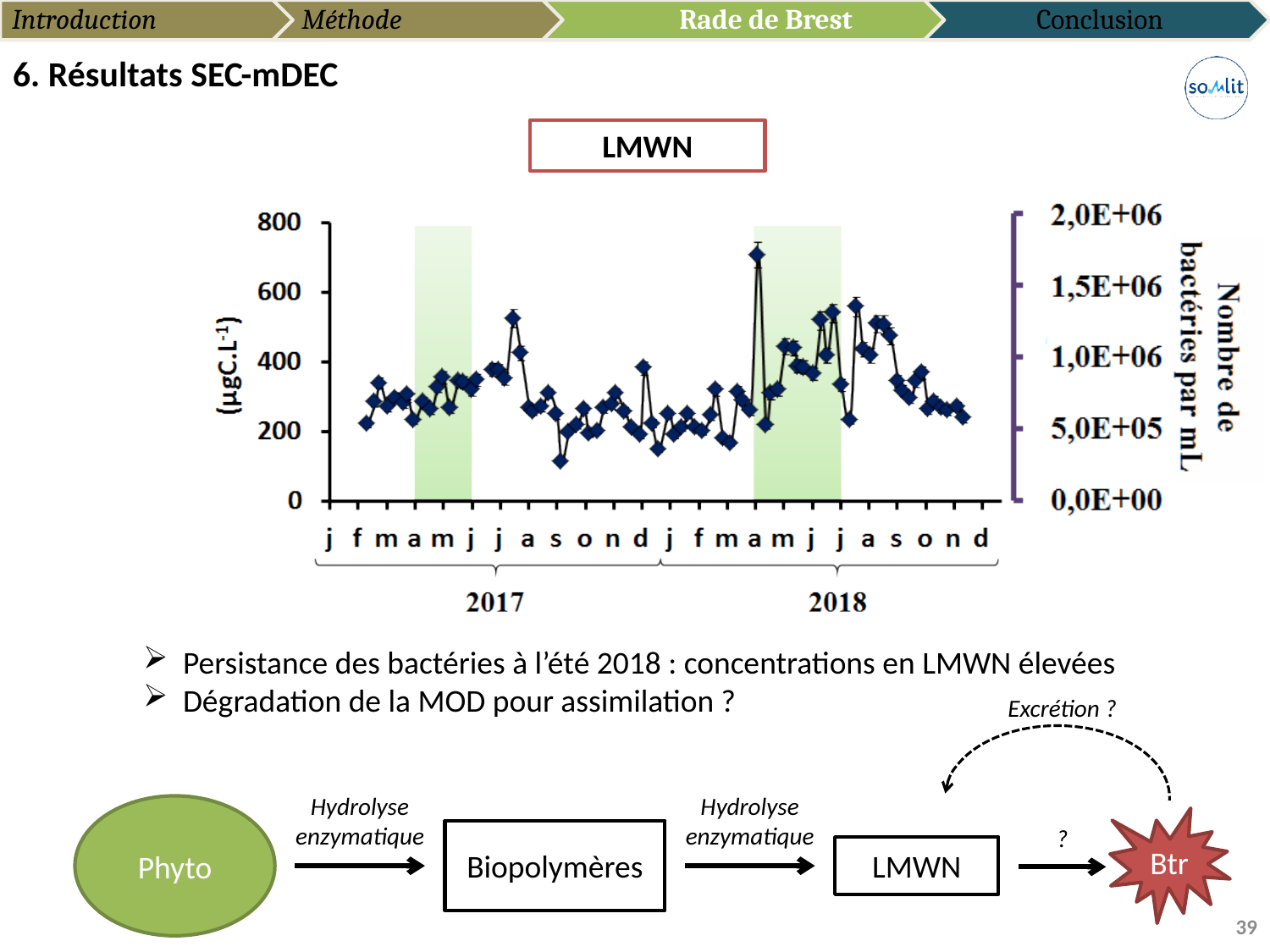
Which two years does the x axis of the chart cover? 2017 and 2018 In which year does the chart reach its lowest value? 2017 What is the label of the right-hand vertical axis of the chart? Nombre de bactéries par mL What is the highest tick value shown on the left vertical axis? 800 What is the highest tick value shown on the right vertical axis? 2,0E+06 Are the values in summer 2018 generally higher or lower than the values in summer 2017? higher Is the lowest value in autumn 2017 greater or less than 200? less Is the value at the start of 2017 (January) greater or less than 400? less What is the title shown above the chart? LMWN In which year does the chart reach its highest value? 2018 What kind of chart is shown on the slide? line chart Is the peak value reached in spring 2018 greater or less than 600? greater